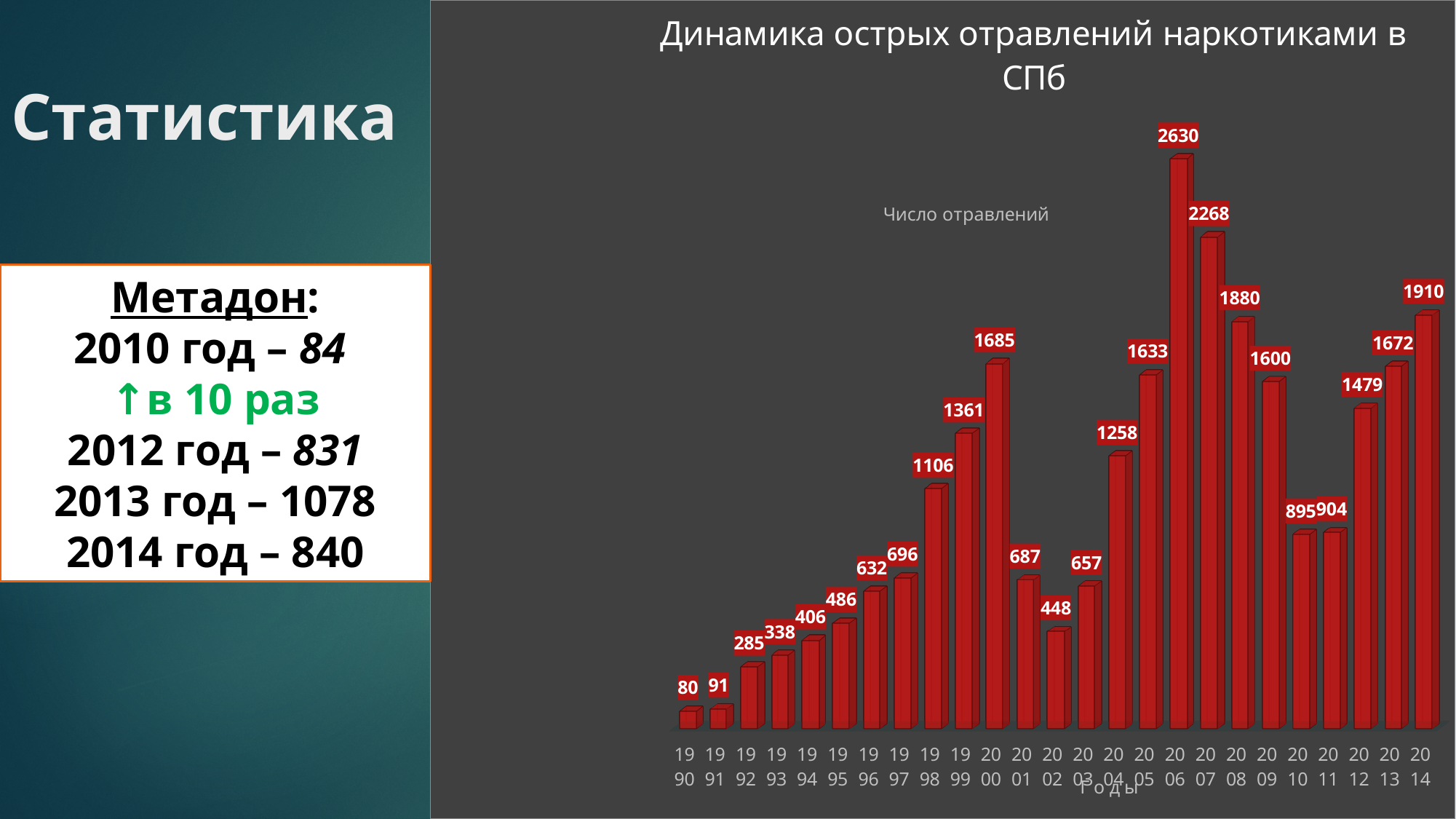
What is the difference between the values for 2010 and 2011? 9 Which year has the highest number of poisonings? 2006 Which year has the lowest number of poisonings? 1990 What is the number of poisonings (Число отравлений) for 2006? 2630 Which year has a larger value, 2000 or 2005? 2000 What is the difference between the values for 2006 and 2007? 362 What is the value shown for 2014? 1910 What type of chart is shown on the slide? bar chart How many years (bars) are plotted in the chart? 25 What is the value shown for 1990? 80 What is the title of the chart? Динамика острых отравлений наркотиками в СПб Do the values rise or fall from 1990 to 2000? rise